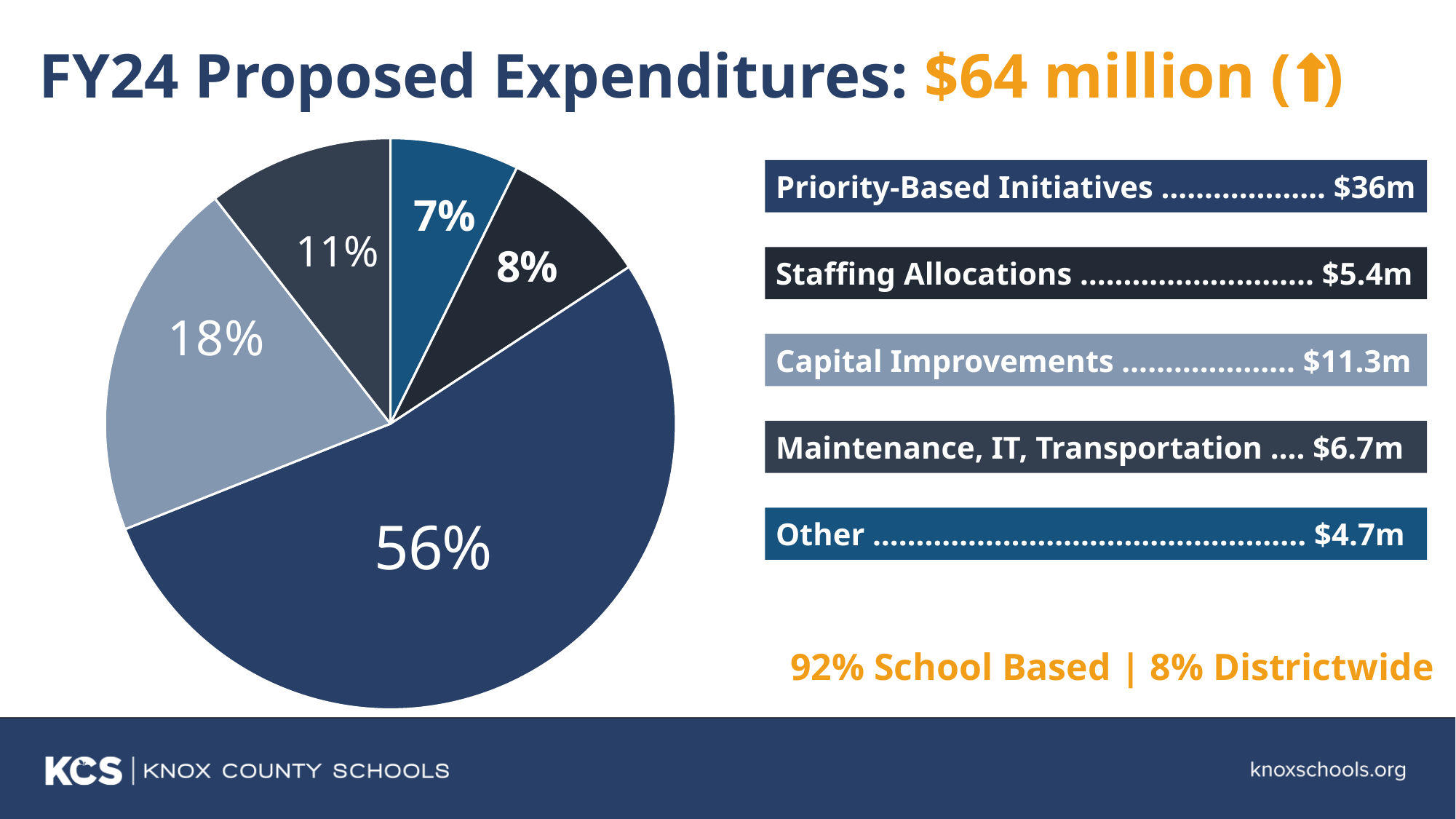
What share of the pie does the Priority-Based Initiatives slice represent? 56% What share of the pie does the Capital Improvements slice represent? 18% What is the title of the slide containing the pie chart? FY24 Proposed Expenditures: $64 million Which category has the smallest slice of the pie? Other How many slices does the pie chart have? 5 What share of the pie does the Other slice represent? 7% Which slice is larger, Staffing Allocations or Maintenance, IT, Transportation? Maintenance, IT, Transportation What is the difference in percentage points between the Priority-Based Initiatives slice and the Capital Improvements slice? 38 What type of chart is shown on the slide? pie chart Which category has the largest slice of the pie? Priority-Based Initiatives